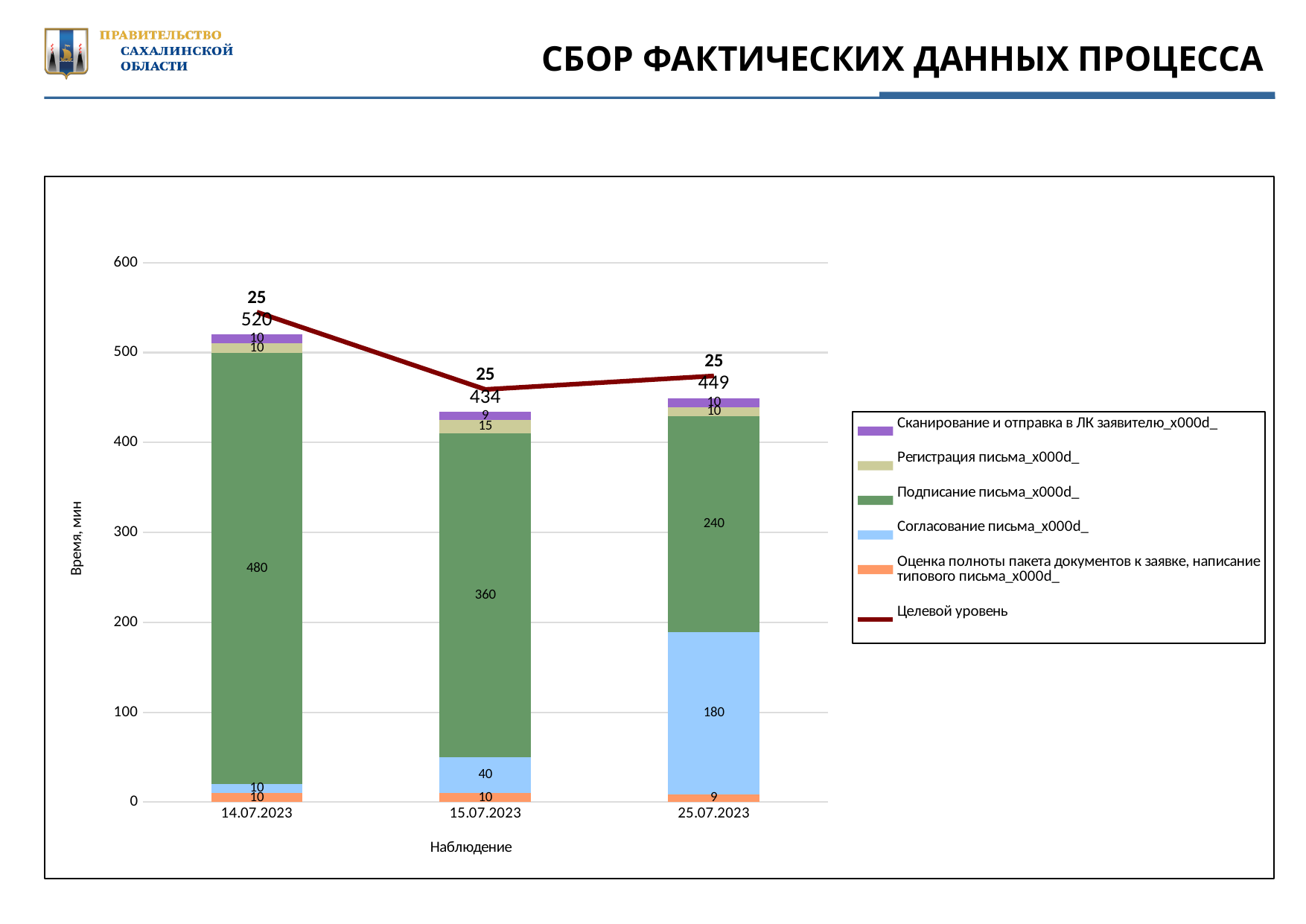
What is the difference between the bar totals for 14.07.2023 and 15.07.2023? 86 What is the y-axis title of the chart? Время, мин How many observation dates are shown on the x axis? 3 Which date has the larger value for Подписание письма, 15.07.2023 or 25.07.2023? 15.07.2023 What kind of chart is shown on the slide? stacked bar chart with a line (combination bar and line chart) How many series does the legend list? 6 What is the total of the stacked bar for 15.07.2023? 434 What is the value of Регистрация письма for 15.07.2023? 15 What is the value of Согласование письма for 25.07.2023? 180 What is the value of Подписание письма for 14.07.2023? 480 Which observation date has the highest stacked bar total? 14.07.2023 Which observation date has the lowest stacked bar total? 15.07.2023